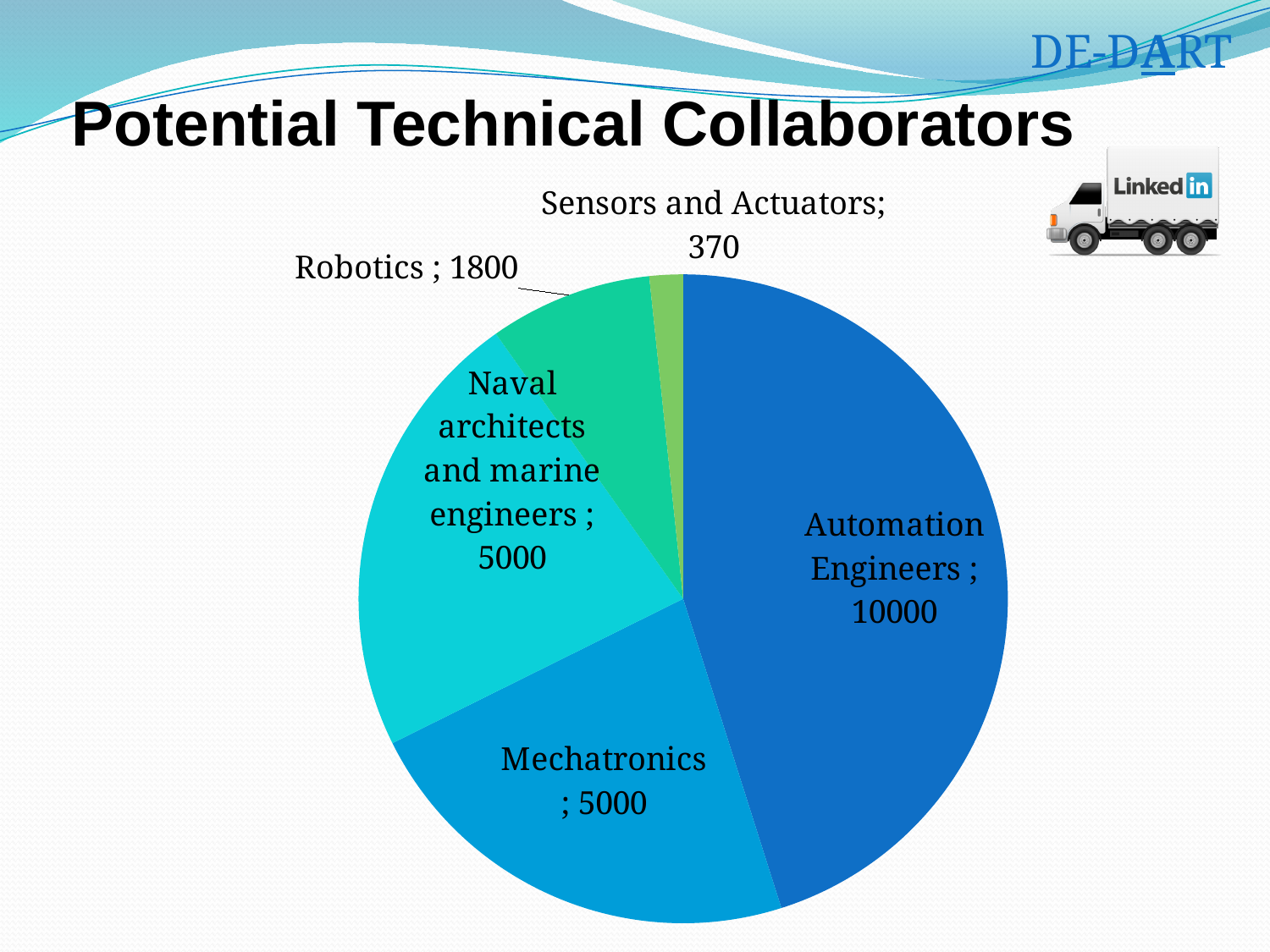
What is the value for Sensors and Actuators? 370 Which category has the largest slice of the pie? Automation Engineers Which category has the smallest slice of the pie? Sensors and Actuators What is the value for Naval architects and marine engineers? 5000 What is the difference between the values for Automation Engineers and Mechatronics? 5000 What is the value for Automation Engineers? 10000 What is the difference between the values for Robotics and Sensors and Actuators? 1430 What is the value for Robotics? 1800 How many categories are shown in the pie chart? 5 What is the title of the slide containing the pie chart? Potential Technical Collaborators What kind of chart is shown on the slide? pie chart Which is larger, the value for Mechatronics or the value for Robotics? Mechatronics